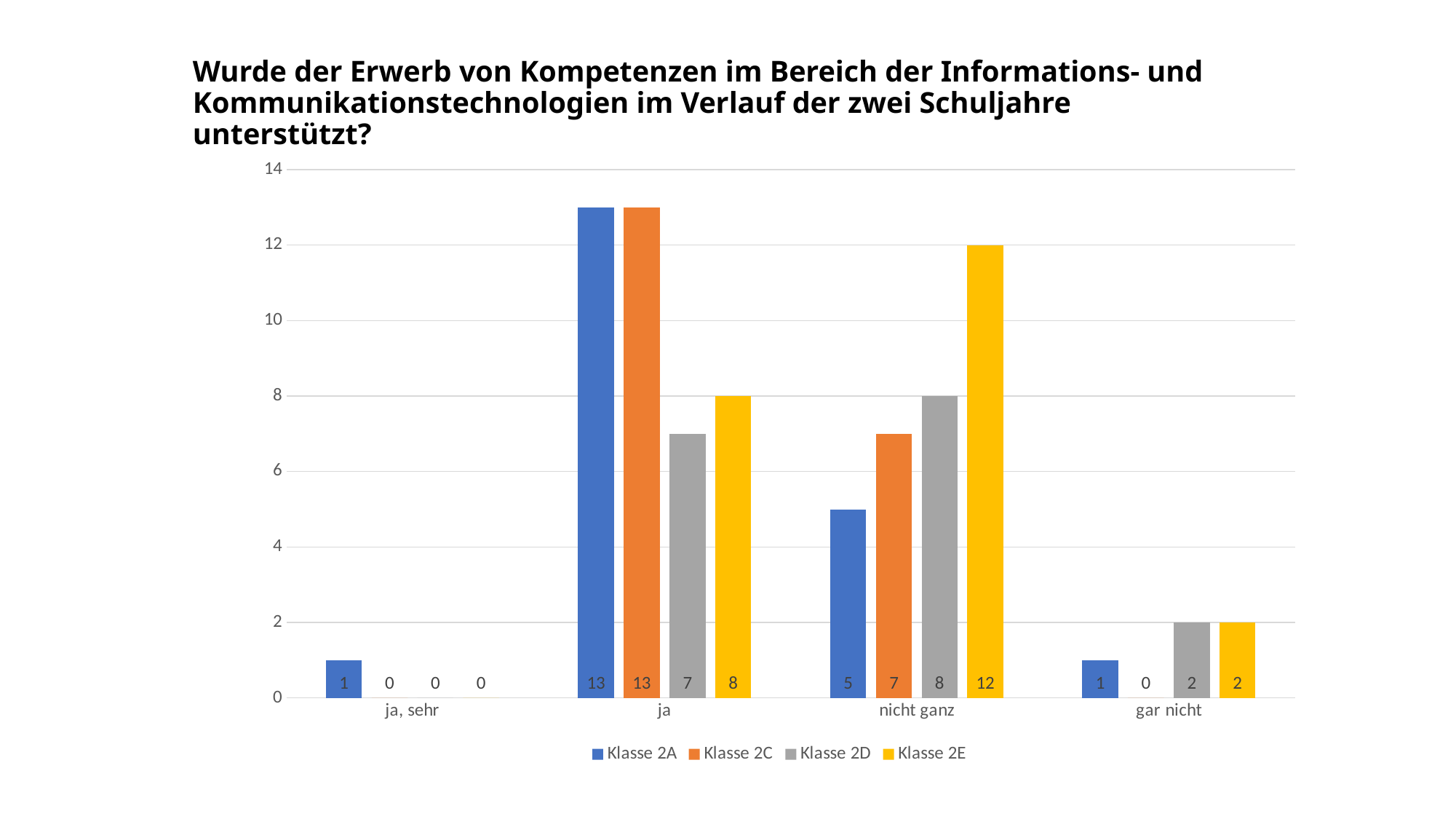
Which colour represents Klasse 2C in the chart? orange What value does Klasse 2E have for the category "nicht ganz"? 12 For the category "ja", which is larger: the value for Klasse 2A or for Klasse 2D? Klasse 2A How many series does the legend list? 4 What value does Klasse 2D have for the category "ja"? 7 What is the difference between the Klasse 2E and Klasse 2A values for "nicht ganz"? 7 What kind of chart is shown on the slide? bar chart How many categories are shown on the x axis? 4 What is the total of the four series values for the category "gar nicht"? 5 Which category has the lowest value for Klasse 2C? ja, sehr and gar nicht (both 0) What value does Klasse 2A have for the category "ja, sehr"? 1 Which category has the highest value for Klasse 2E? nicht ganz